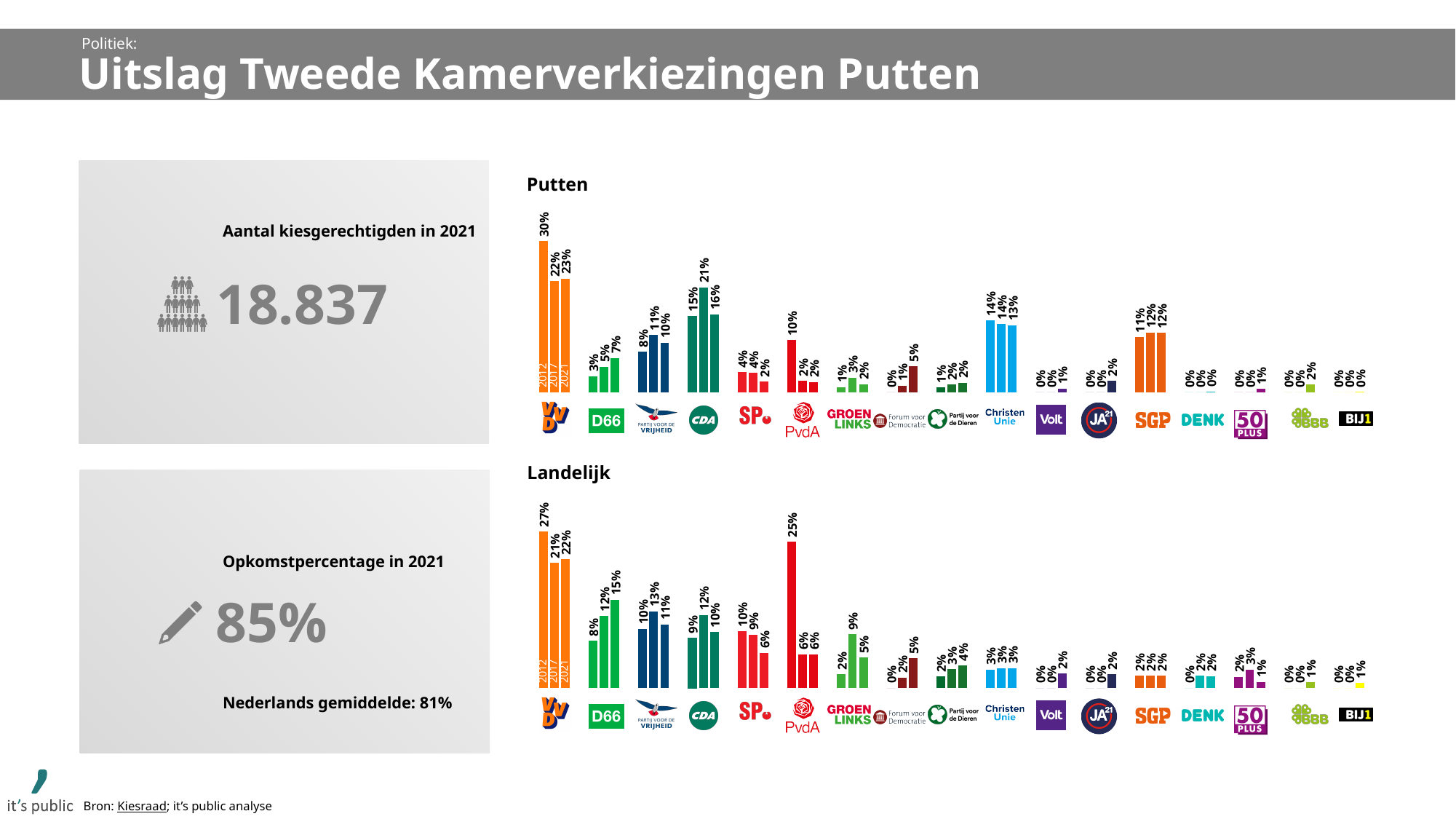
In the Putten chart, which is larger: the ChristenUnie's 2021 percentage or the SGP's 2021 percentage? ChristenUnie In the Landelijk chart, which party had the highest percentage in 2021? VVD In the Putten chart, what is the difference between the VVD's 2012 and 2017 percentages? 8% In the Putten chart, did D66's percentage rise or fall from 2012 to 2021? rise In the Putten chart, what percentage did the VVD get in 2021? 23% In the Putten chart, which party had the highest percentage in 2012? VVD How many years (bars per party) are shown for each party in the Putten chart? 3 In the Putten chart, what percentage did the CDA get in 2017? 21% In the Landelijk chart, what percentage did the PvdA get in 2012? 25% What type of chart is the Landelijk chart? bar chart In the Landelijk chart, what percentage did D66 get in 2021? 15% In the Landelijk chart, what is the difference between the PvdA's 2012 and 2017 percentages? 19%